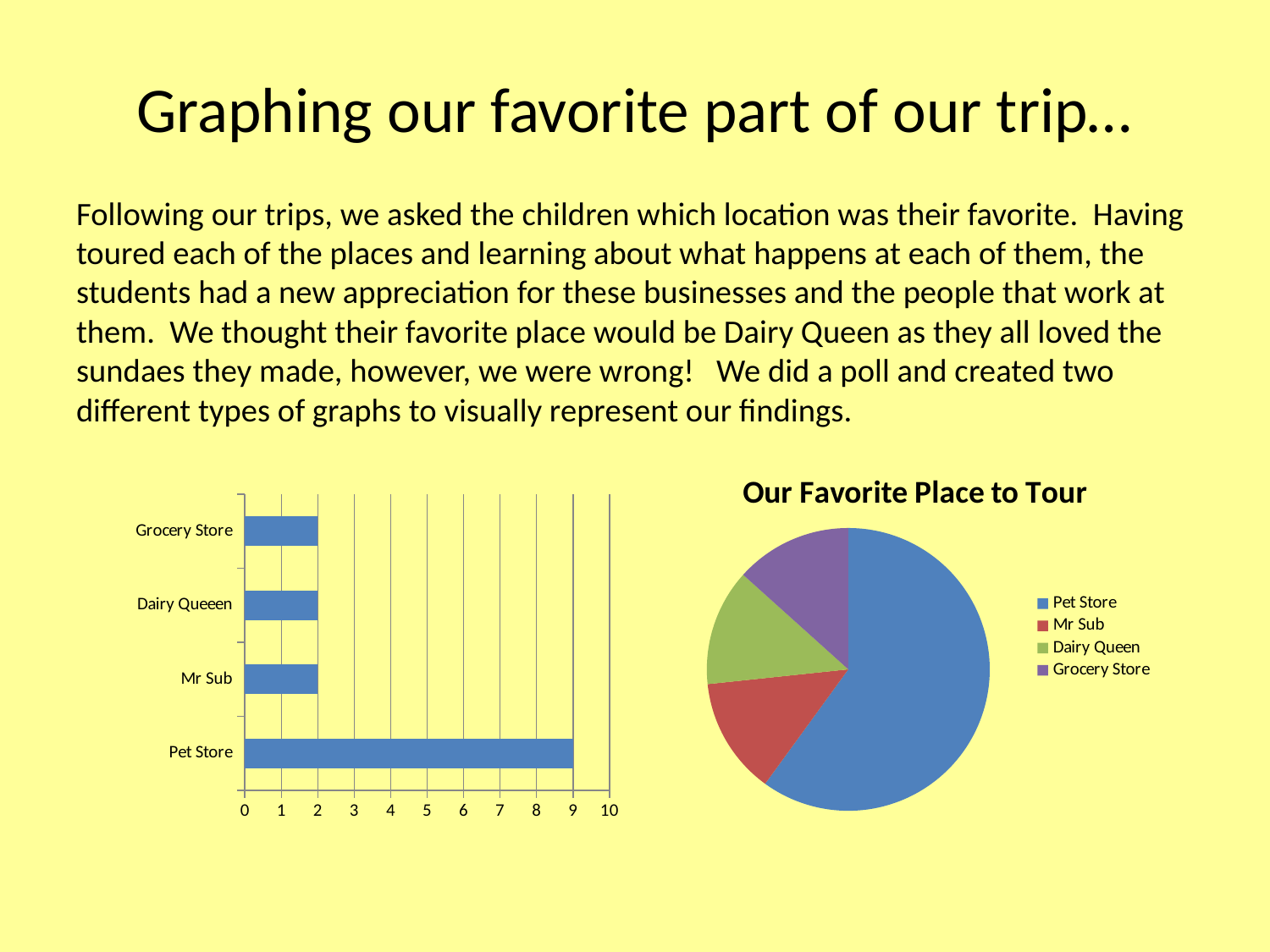
In the bar chart on the left, what is the difference between the values for Pet Store and Dairy Queen? 7 In the bar chart on the left, which category has the highest value? Pet Store In the bar chart on the left, is the value for Pet Store greater or less than 5? greater In the pie chart titled "Our Favorite Place to Tour", which slice is the largest? Pet Store In the bar chart on the left, what is the value for Pet Store? 9 What kind of chart is the chart on the left of the slide? bar chart In the bar chart on the left, how many categories are shown? 4 How many entries does the legend of the pie chart "Our Favorite Place to Tour" list? 4 In the bar chart on the left, which is larger, the value for Pet Store or the value for Mr Sub? Pet Store What kind of chart is the chart titled "Our Favorite Place to Tour"? pie chart In the bar chart on the left, what is the value for Grocery Store? 2 In the bar chart on the left, what is the value for Mr Sub? 2